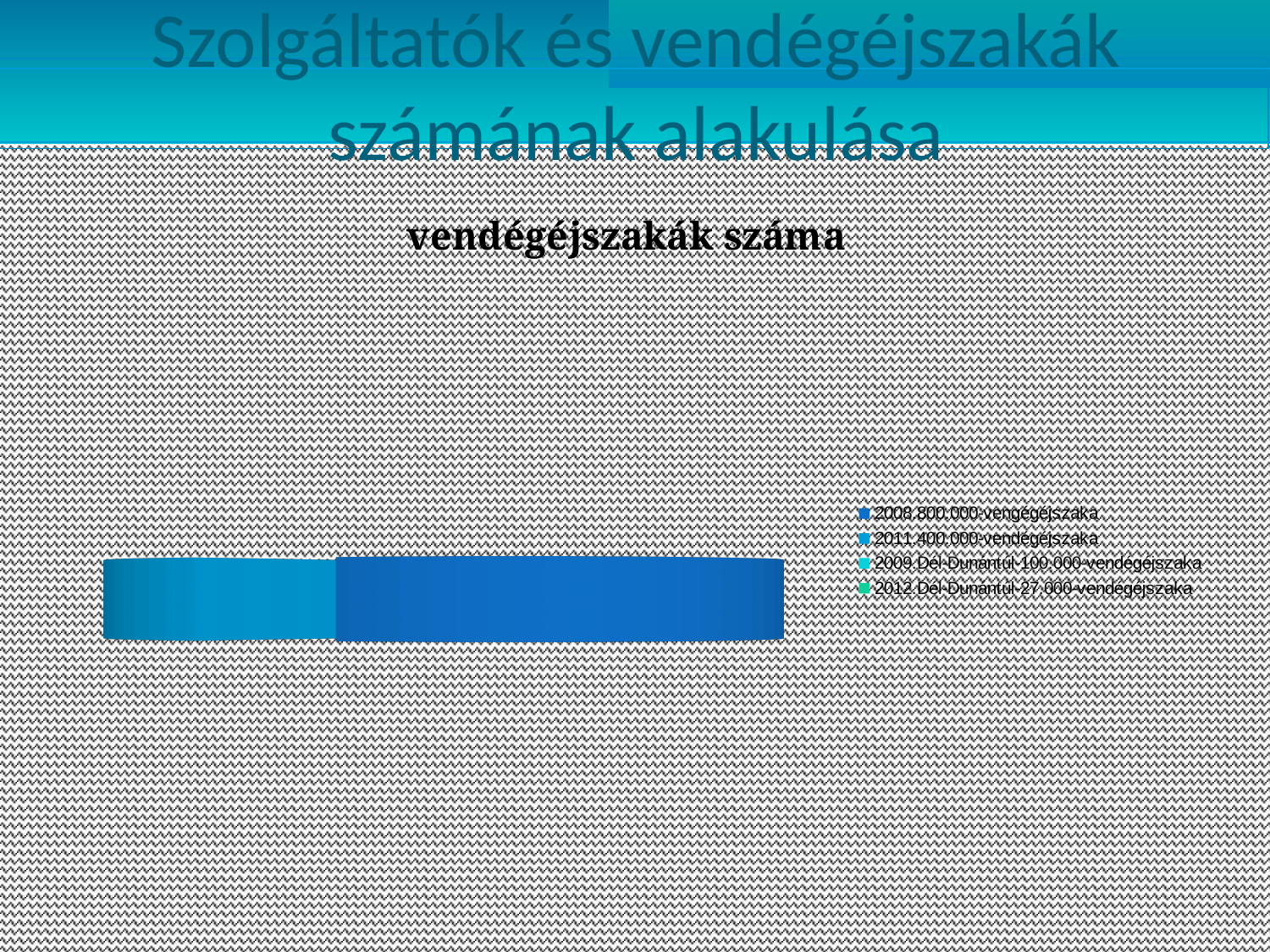
How many entries does the chart's legend list? 4 According to the legend, how many vendégéjszaka are listed for 2012 Dél-Dunántúl? 27.000 According to the legend, how many vendégéjszaka are listed for 2011? 400.000 According to the legend, how many vendégéjszaka are listed for 2009 Dél-Dunántúl? 100.000 Which legend entry shows the smallest number of vendégéjszaka? 2012 Dél-Dunántúl (27.000) Which legend entry shows the largest number of vendégéjszaka? 2008 (800.000) What is the difference between the 2008 value (800.000) and the 2011 value (400.000) shown in the legend? 400.000 Which has more vendégéjszaka in the legend, 2008 or 2011? 2008 Which region is named in the legend entries for 2009 and 2012? Dél-Dunántúl What is the title of the chart on the slide? vendégéjszakák száma What is the difference between the 2009 Dél-Dunántúl value (100.000) and the 2012 Dél-Dunántúl value (27.000) shown in the legend? 73.000 According to the legend, how many vendégéjszaka are listed for 2008? 800.000